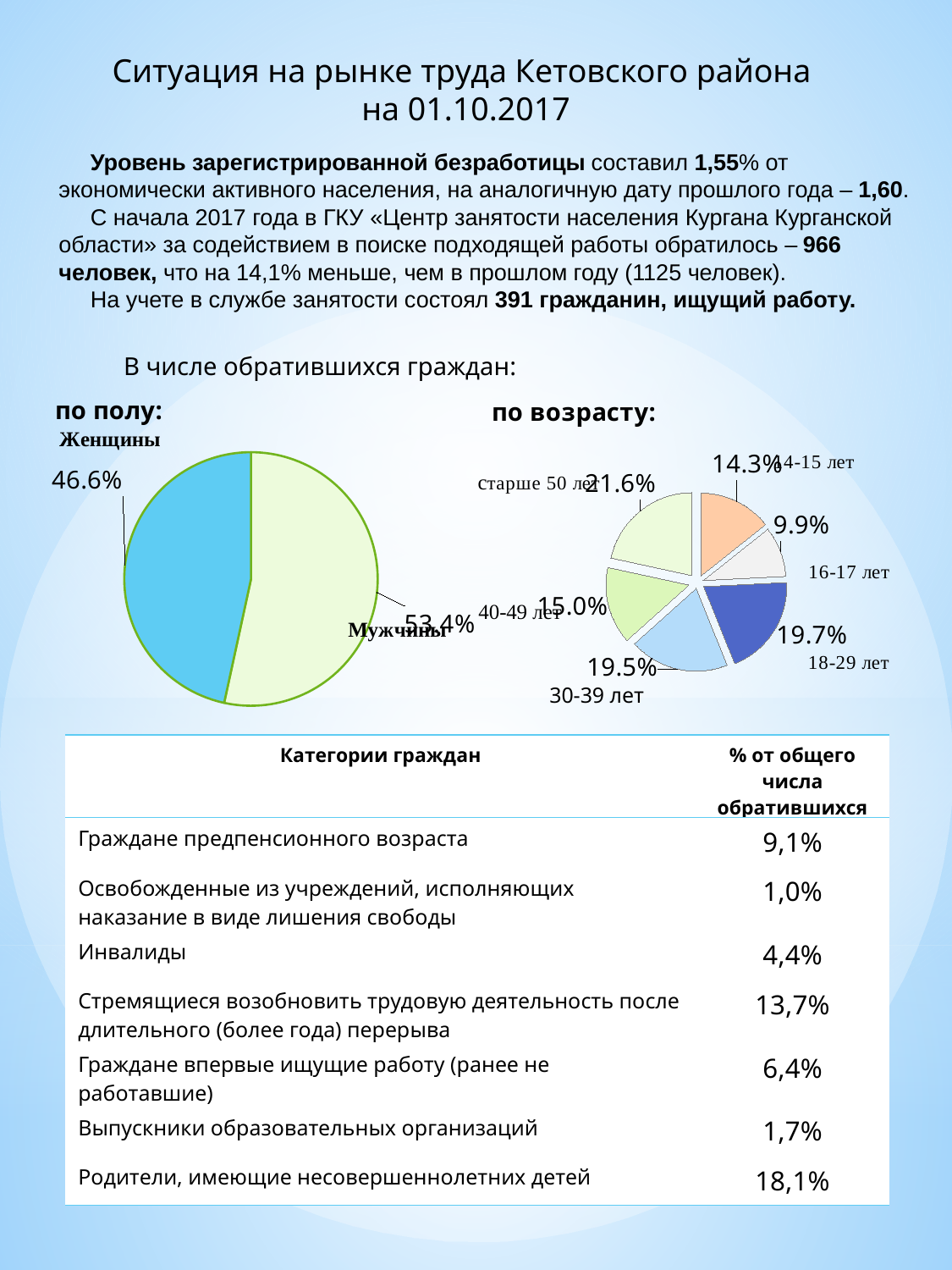
In the 'по полу' pie chart, which slice is larger, Женщины or Мужчины? Мужчины How many slices does the 'по возрасту' pie chart have? 6 In the 'по полу' pie chart, what is the difference between the Мужчины and Женщины shares? 6.8% What type of chart is the 'по возрасту' chart? Pie chart In the 'по полу' pie chart, what share is labelled for Мужчины? 53.4% In the 'по возрасту' pie chart, what share is labelled for 16-17 лет? 9.9% In the 'по возрасту' pie chart, which slice is larger, 40-49 лет or 14-15 лет? 40-49 лет In the 'по возрасту' pie chart, what share is labelled for старше 50 лет? 21.6% In the 'по возрасту' pie chart, which age group has the largest share? старше 50 лет In the 'по возрасту' pie chart, what share is labelled for 14-15 лет? 14.3% In the 'по полу' pie chart, what share is labelled for Женщины? 46.6% In the 'по возрасту' pie chart, which age group has the smallest share? 16-17 лет